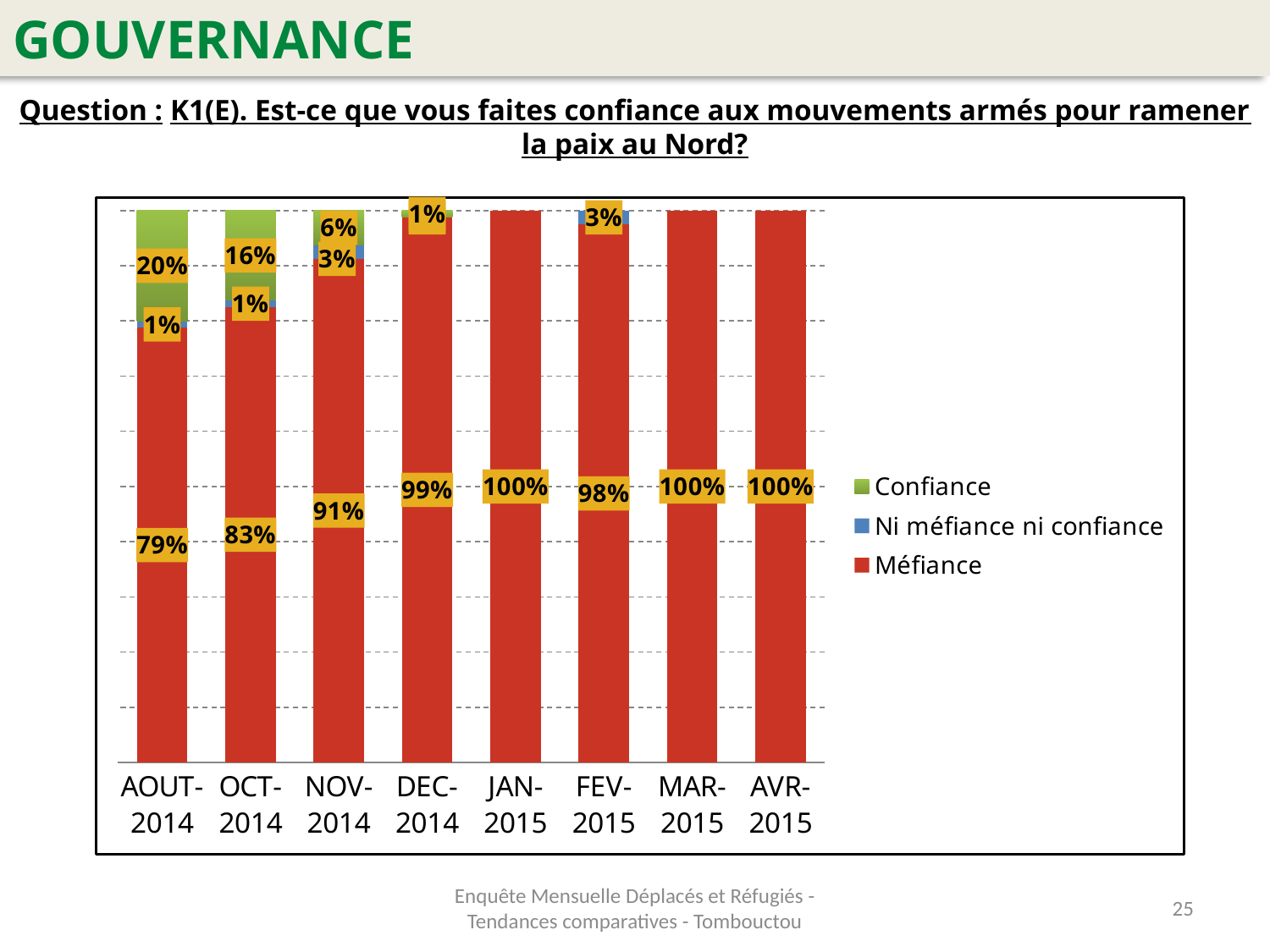
What is the Méfiance value for NOV-2014? 91% What is the Confiance value for OCT-2014? 16% How many months are shown on the x axis? 8 Which month has the highest Confiance value? AOUT-2014 Which is larger, the Méfiance value for OCT-2014 or for DEC-2014? DEC-2014 What is the Méfiance value for AOUT-2014? 79% How many series does the legend list? 3 What is the difference between the Méfiance values for NOV-2014 and AOUT-2014? 12% Which month has the lowest Méfiance value? AOUT-2014 What kind of chart is shown on the slide? Stacked bar chart What is the Confiance value for AOUT-2014? 20% Does the Méfiance value rise or fall from AOUT-2014 to JAN-2015? Rise